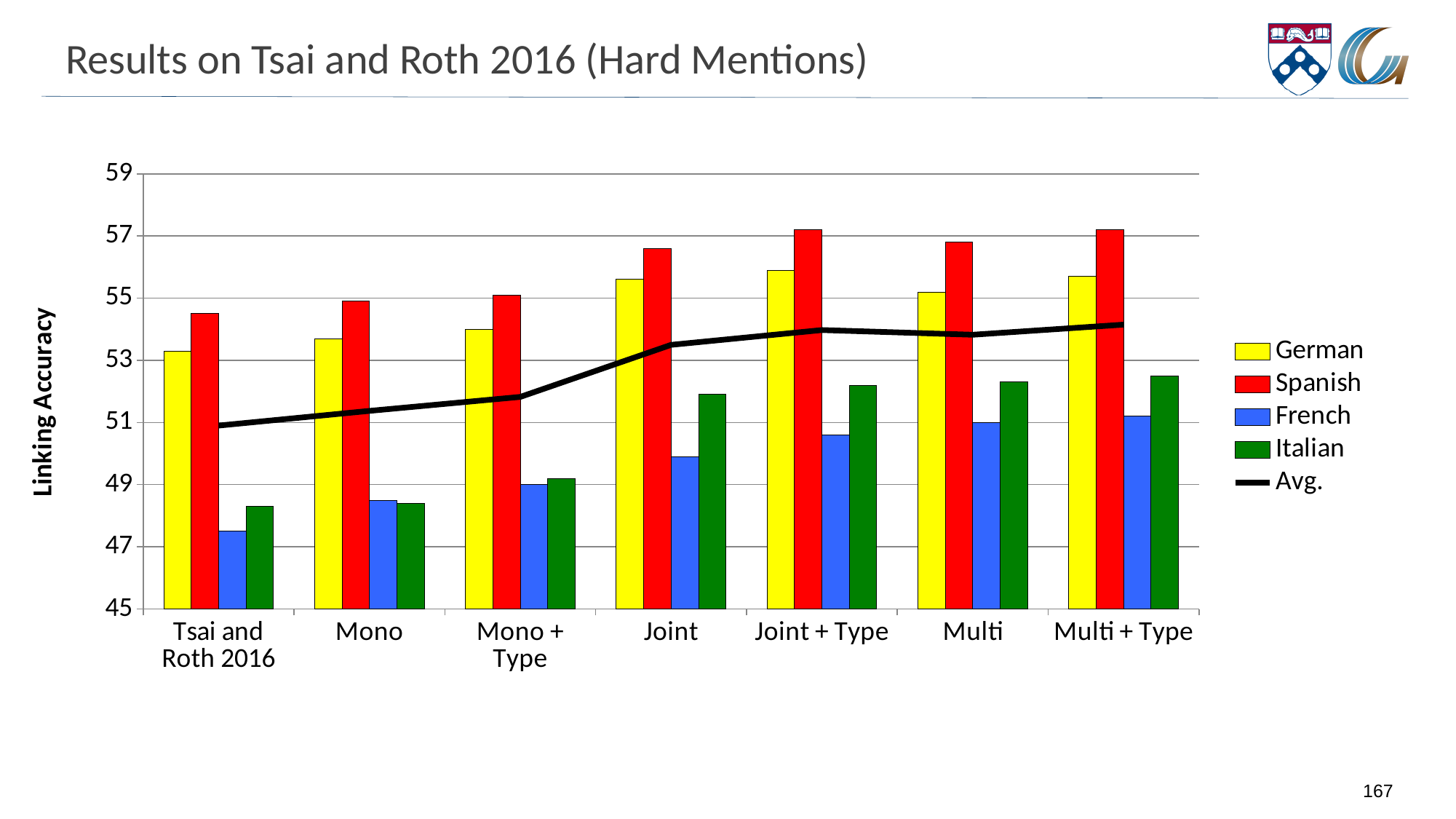
For Joint, which is larger, the French value or the Italian value? Italian Is the French value for Tsai and Roth 2016 greater or less than 49? less Which category has the lowest Spanish value? Tsai and Roth 2016 Does the Avg. line generally rise or fall from left to right across the categories? rise What is the label on the y axis? Linking Accuracy How many series does the legend list? 5 Which category has the lowest French value? Tsai and Roth 2016 Is the Italian value for Joint greater or less than 51? greater How many categories are shown along the x axis? 7 What kind of chart is shown on the slide? combination bar and line chart Is the Avg. value for Joint greater or less than 53? greater For Mono, which is larger, the German value or the Spanish value? Spanish